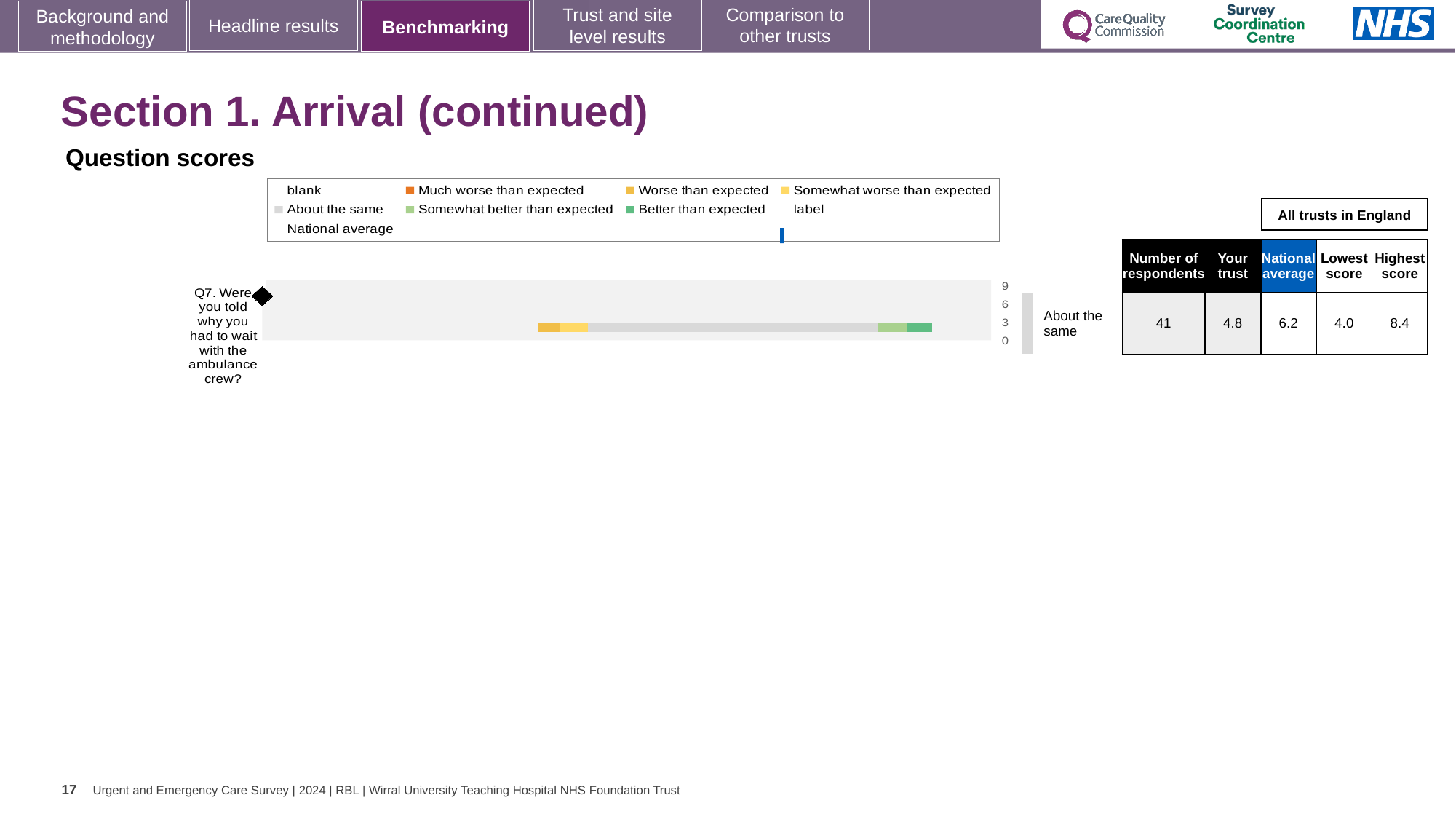
How many questions are plotted in the Question scores chart? 1 In the table next to the chart, what is the "Your trust" score for Q7? 4.8 Is the "Your trust" score for Q7 higher or lower than the national average? lower In the table next to the chart, what is the number of respondents for Q7? 41 In the table next to the chart, what is the national average score for Q7? 6.2 What is the difference between the national average and the "Your trust" score for Q7? 1.4 In the table next to the chart, what is the highest score for Q7? 8.4 Which question is plotted in the Question scores chart? Q7. Were you told why you had to wait with the ambulance crew? What benchmark category is shown to the right of the bar for Q7? About the same What is the difference between the highest score and the lowest score for Q7? 4.4 What kind of chart is shown under "Question scores"? bar chart In the table next to the chart, what is the lowest score for Q7? 4.0